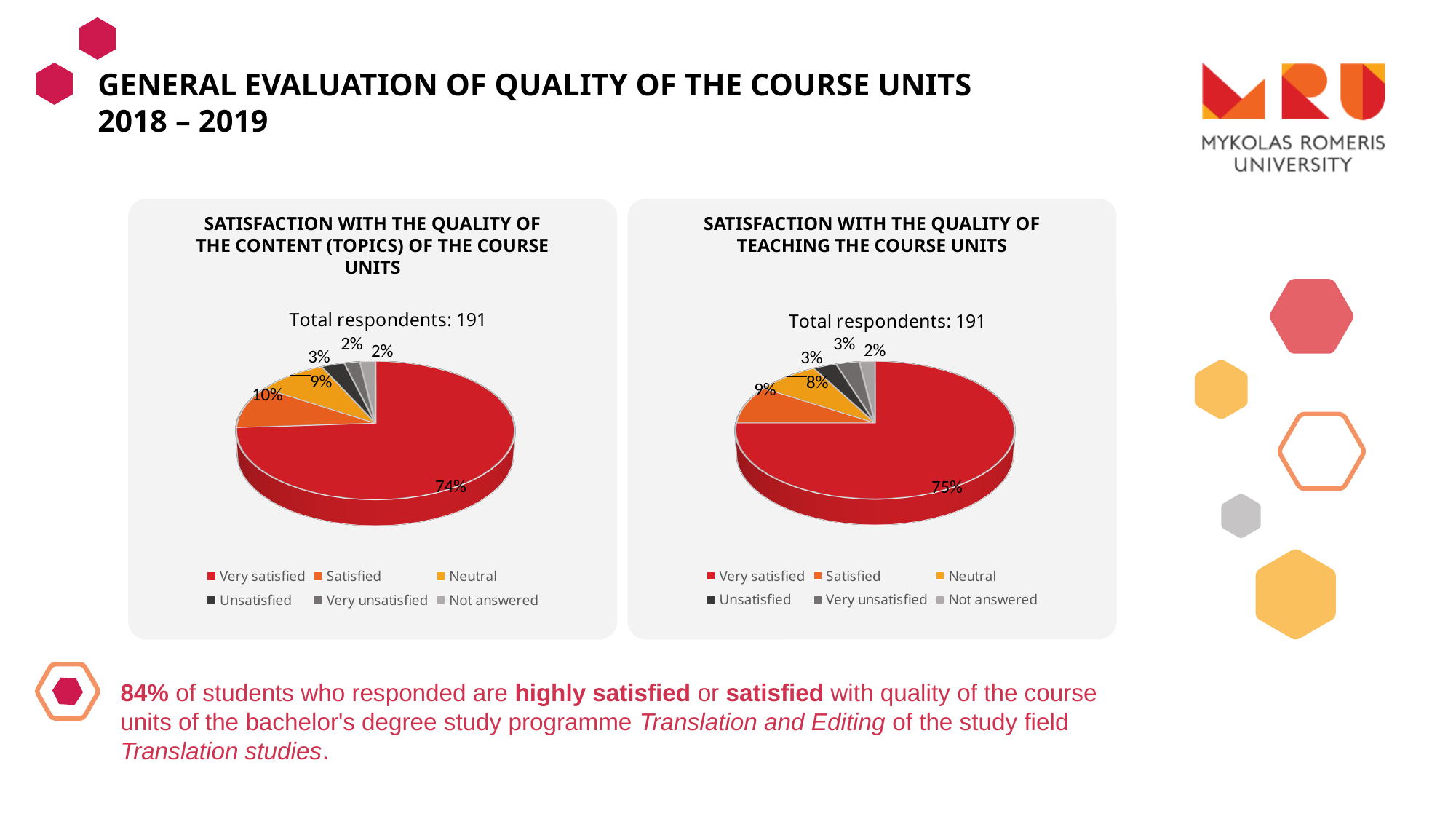
How many categories does the legend list in the chart 'Satisfaction with the quality of teaching the course units'? 6 In the chart 'Satisfaction with the quality of teaching the course units', what share of respondents were very satisfied? 75% In the chart 'Satisfaction with the quality of the content (topics) of the course units', what percentage of respondents were satisfied? 10% Which chart shows a larger share of very satisfied respondents: the content (topics) chart or the teaching chart? The teaching chart How many total respondents are reported for the chart 'Satisfaction with the quality of the content (topics) of the course units'? 191 In the chart 'Satisfaction with the quality of the content (topics) of the course units', which category has the largest share? Very satisfied In the chart 'Satisfaction with the quality of teaching the course units', what colour represents the 'Very satisfied' category? Red What type of chart is used on the slide for 'Satisfaction with the quality of the content (topics) of the course units'? Pie chart In the chart 'Satisfaction with the quality of teaching the course units', which category has the smallest share? Not answered In the chart 'Satisfaction with the quality of the content (topics) of the course units', what is the difference between the Satisfied and Neutral shares? 1% In the chart 'Satisfaction with the quality of teaching the course units', what percentage of respondents were neutral? 8% In the chart 'Satisfaction with the quality of the content (topics) of the course units', what share of respondents were very satisfied? 74%